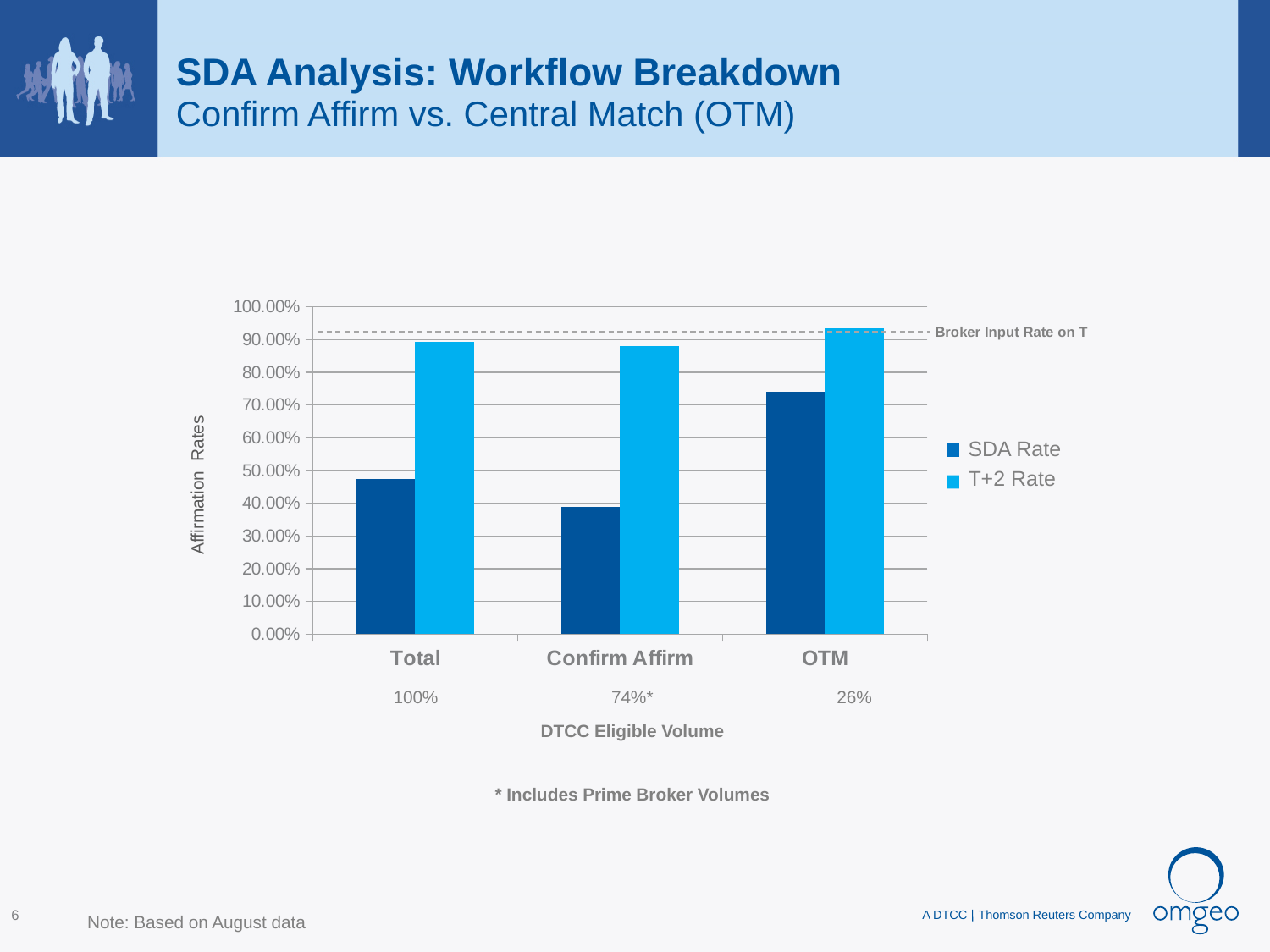
How many categories are shown on the x axis? 3 Which category has the highest SDA Rate? OTM Which category has the lowest SDA Rate? Confirm Affirm Is the SDA Rate for OTM greater or less than 70.00%? greater Which category has the highest T+2 Rate? OTM Is the T+2 Rate for Confirm Affirm greater or less than 80.00%? greater How many series does the legend list? 2 For Confirm Affirm, which is larger: the SDA Rate or the T+2 Rate? T+2 Rate Is the SDA Rate for Total greater or less than 50.00%? less What is the label of the y axis? Affirmation Rates What kind of chart is shown on the slide? bar chart